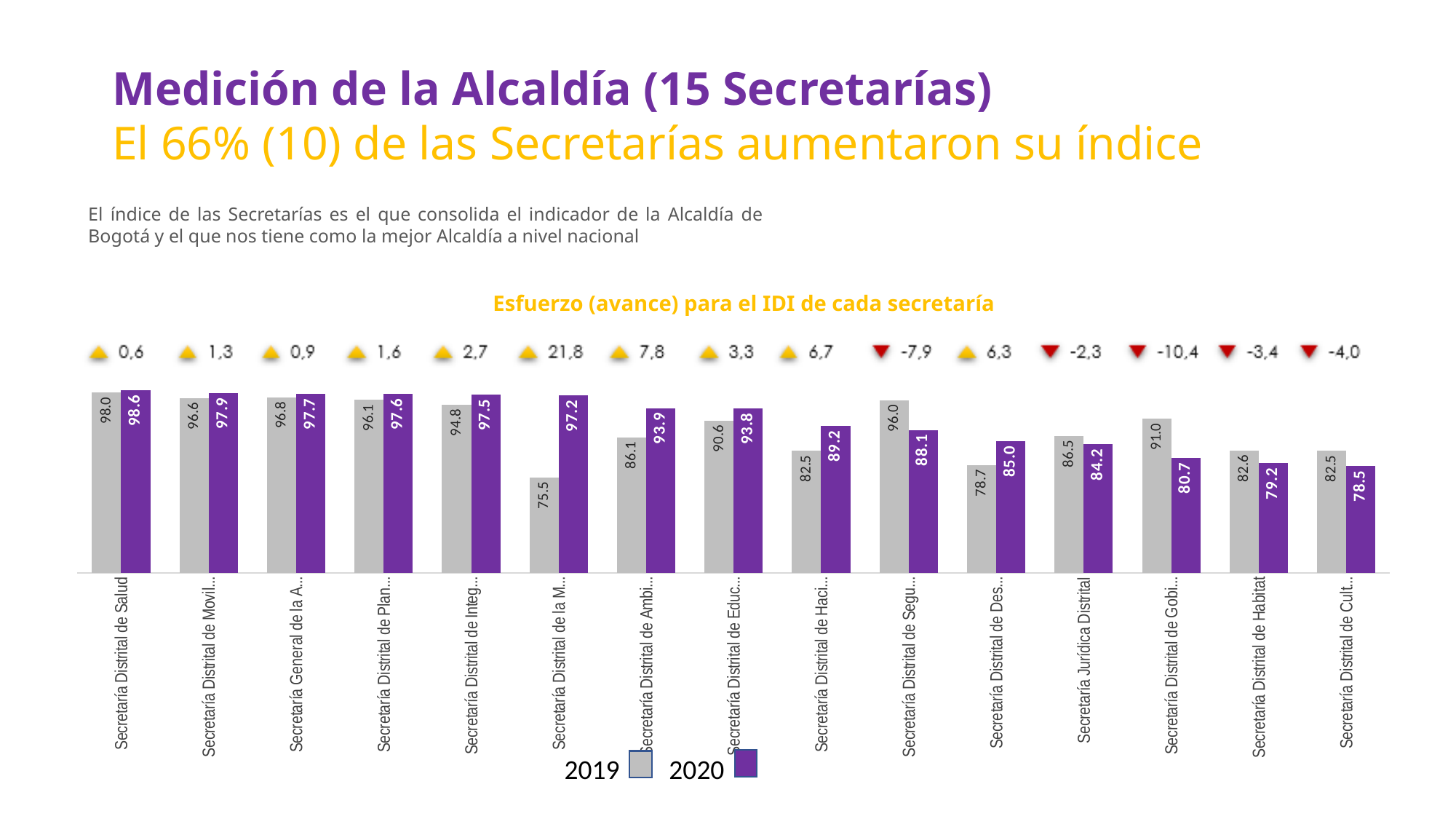
What is the 2020 value for Secretaría Distrital de Salud? 98.6 How many categories (secretarías) are shown in the chart? 15 What is the difference between the 2019 and 2020 values for Secretaría Jurídica Distrital? 2.3 What is the highest 2019 value shown in the chart? 98.0 Which category has the highest 2020 value? Secretaría Distrital de Salud What kind of chart is shown on the slide? Bar chart What is the lowest 2020 value shown in the chart? 78.5 What is the 2019 value for Secretaría Jurídica Distrital? 86.5 How many series does the legend list? 2 What is the 2020 value for Secretaría Distrital de Habitat? 79.2 For Secretaría Distrital de Habitat, which is larger: the 2019 value or the 2020 value? 2019 What is the title of the chart? Esfuerzo (avance) para el IDI de cada secretaría